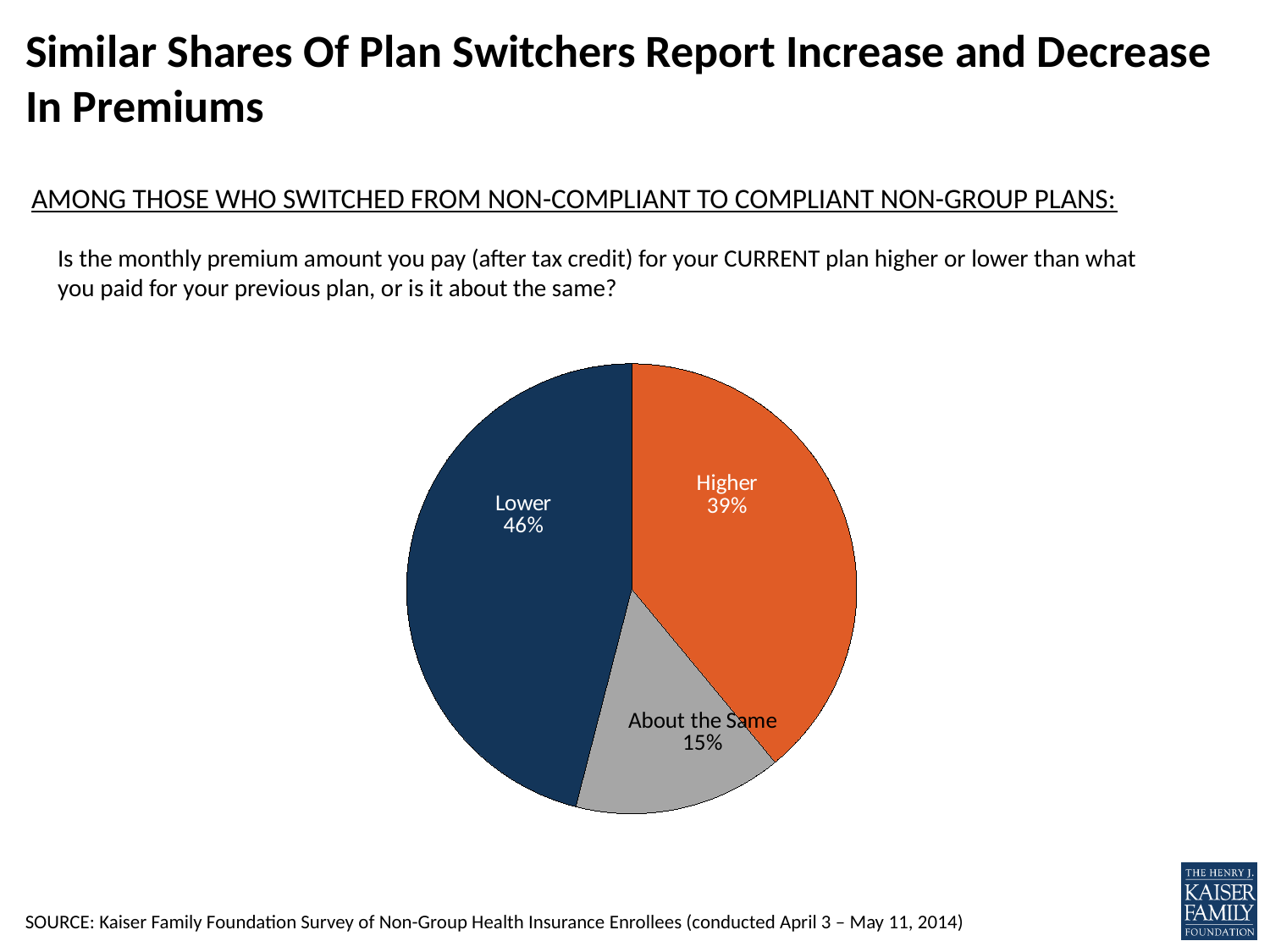
What is the combined share of those reporting Higher and About the Same? 54% What kind of chart is shown on the slide? Pie chart What share of plan switchers report their current premium is higher? 39% What colour is the slice for Higher? Orange What is the difference in percentage points between the Lower and Higher shares? 7 percentage points What share of plan switchers report their current premium is lower? 46% What colour is the slice for Lower? Dark blue Which response has the largest share of the pie? Lower Which is larger, the share reporting Higher or the share reporting About the Same? Higher What share of plan switchers report their current premium is about the same? 15% How many slices does the pie chart have? 3 Which response has the smallest share of the pie? About the Same